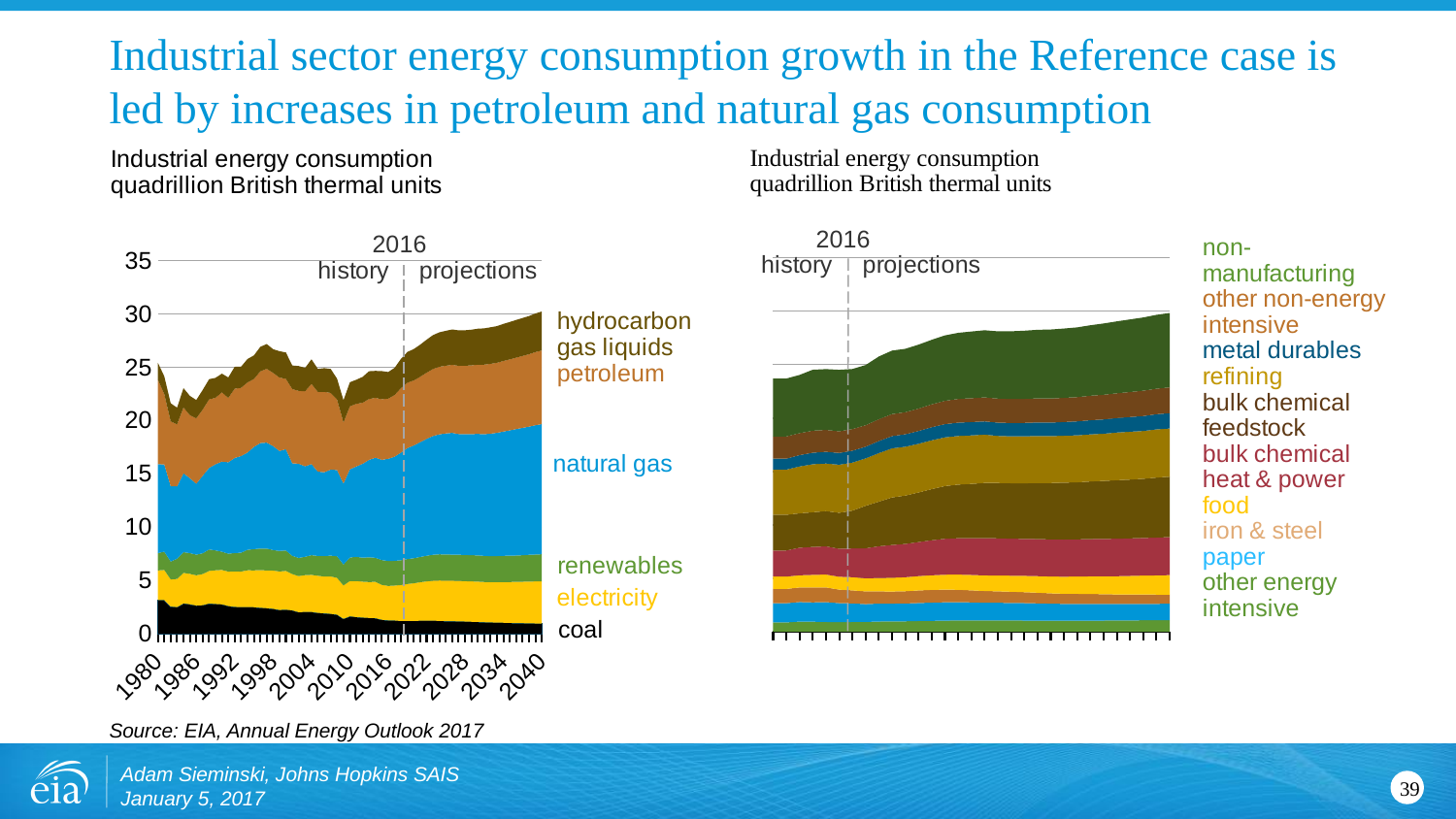
On the left chart, which fuel series is the largest band in the projection period? natural gas On the left chart, does natural gas consumption rise or fall over the projection period from 2016 to 2040? rise On the left chart, is the total industrial energy consumption in 1980 greater or less than 20 quadrillion Btu? greater What year does the dashed vertical line separating history from projections mark on both charts? 2016 What kind of chart is the left chart, 'Industrial energy consumption' by fuel? stacked area chart On the right chart, which industry series is the largest band at the top of the stack? non-manufacturing How many fuel series are labelled on the left chart? 6 On the left chart, which fuel series is the smallest band by 2040? coal On the left chart, is the coal band in 2040 greater or less than 5 quadrillion Btu? less What is the unit shown in the subtitle of both charts? quadrillion British thermal units How many industry series are labelled on the right chart? 10 On the left chart, does coal consumption rise or fall from 1980 to 2040? fall